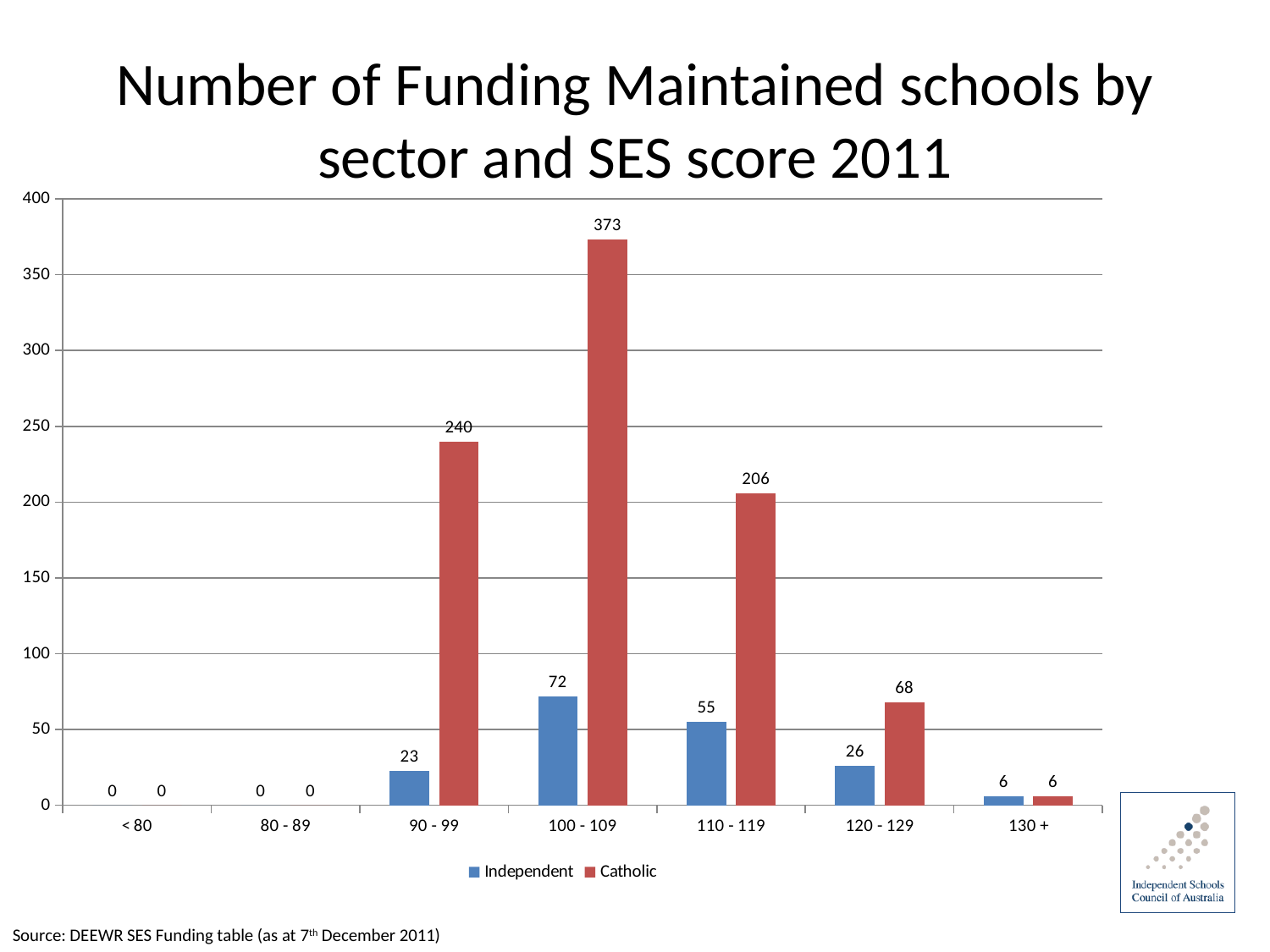
Which is larger in the 110 - 119 band, the Independent value or the Catholic value? Catholic What is the title of the chart? Number of Funding Maintained schools by sector and SES score 2011 How many series does the legend list? 2 Which SES score band has the highest number of Catholic schools? 100 - 109 What kind of chart is shown on the slide? Bar chart What is the number of Catholic Funding Maintained schools with an SES score of 100 - 109? 373 How many SES score bands are shown on the x axis? 7 What is the total number of Funding Maintained schools (Independent plus Catholic) in the 130 + SES score band? 12 Which SES score band has the highest number of Independent schools? 100 - 109 What is the value for Independent schools in the 90 - 99 SES score band? 23 What is the number of Independent Funding Maintained schools with an SES score of 110 - 119? 55 What is the difference between the Catholic and Independent values in the 120 - 129 SES score band? 42